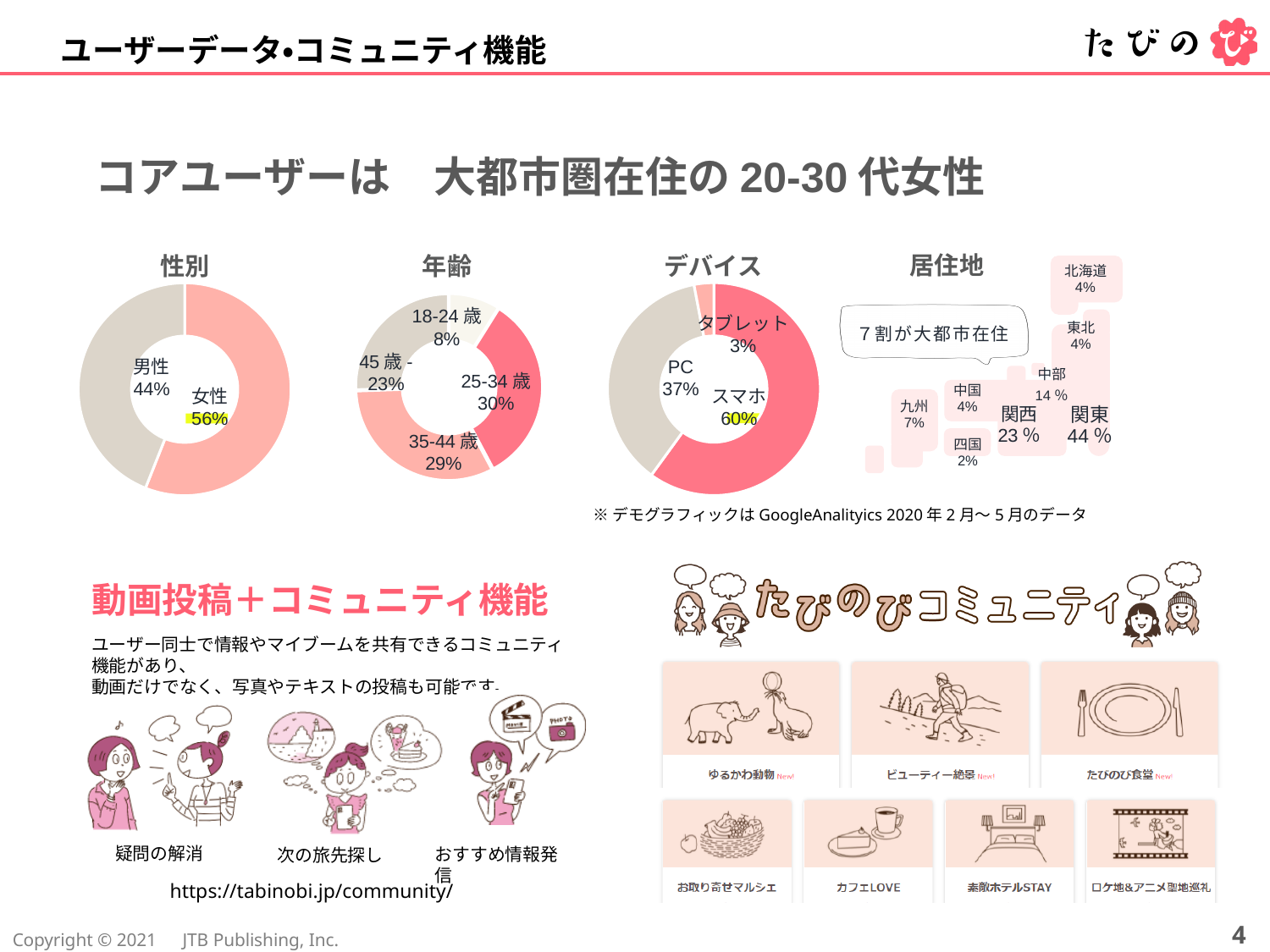
In the 年齢 chart, which age group has the smallest share? 18-24 歳 In the 性別 chart, what is the difference between the 女性 and 男性 shares? 12% In the 性別 chart, which category has the larger share, 男性 or 女性? 女性 In the 年齢 chart, how many age categories are labelled? 4 In the 年齢 chart, what percentage is 18-24 歳? 8% In the 性別 chart, what percentage is 男性? 44% In the デバイス chart, what percentage is PC? 37% In the 性別 chart, what percentage is 女性? 56% In the デバイス chart, which device has the largest share? スマホ In the デバイス chart, what percentage is スマホ? 60% In the 年齢 chart, what percentage is 25-34 歳? 30% What kind of chart is the 性別 chart? Donut (pie) chart